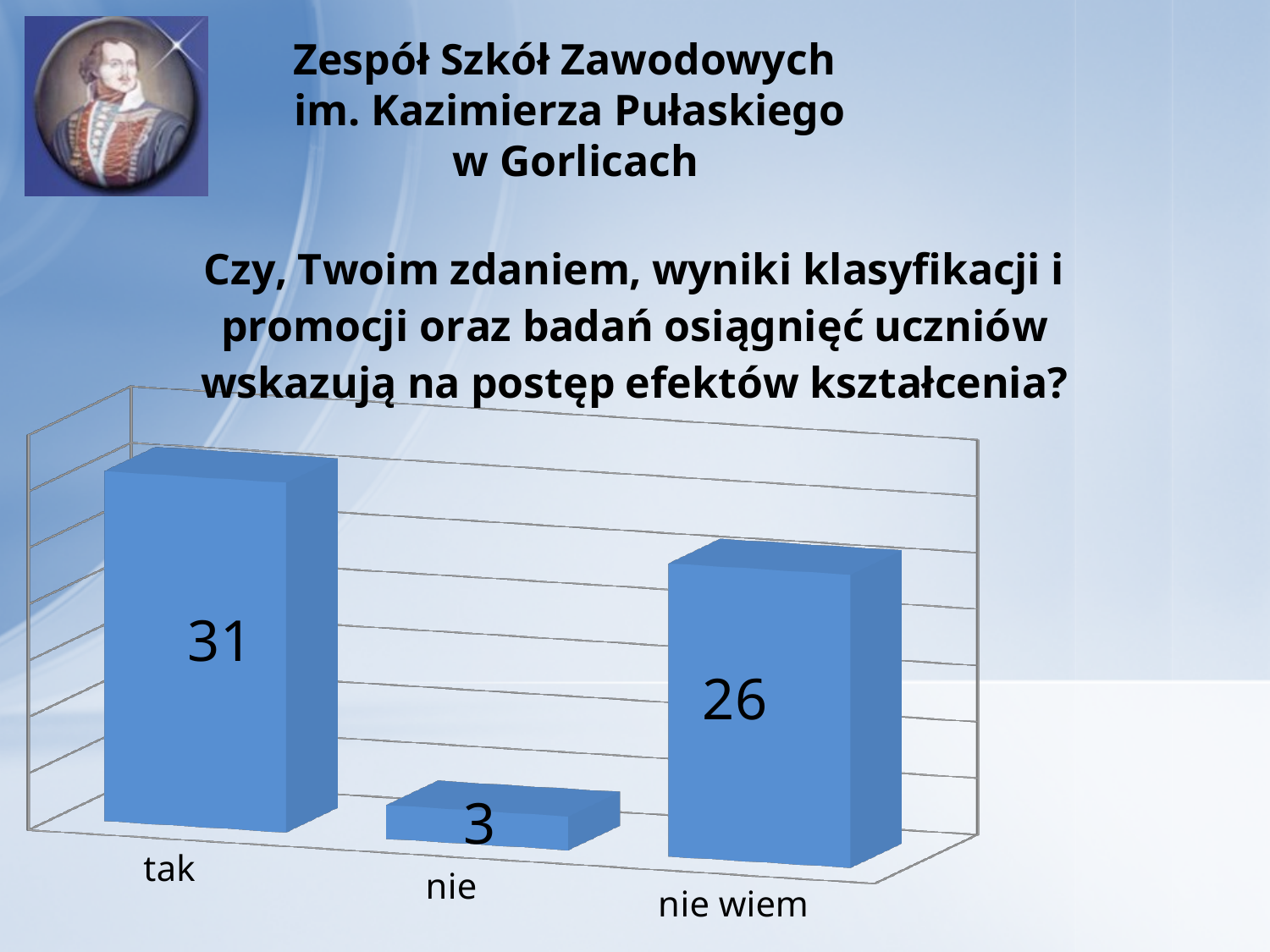
Which category has the lowest value? nie Which is larger, the value for "tak" or the value for "nie wiem"? tak What is the difference between the values for "tak" and "nie wiem"? 5 What is the value for "nie"? 3 What kind of chart is shown on the slide? bar chart What is the value for "nie wiem"? 26 Which category has the highest value? tak How many categories are shown in the chart? 3 What is the difference between the values for "nie wiem" and "nie"? 23 What is the total of all three values shown in the chart? 60 What is the value for "tak"? 31 What colour are the bars in the chart? blue